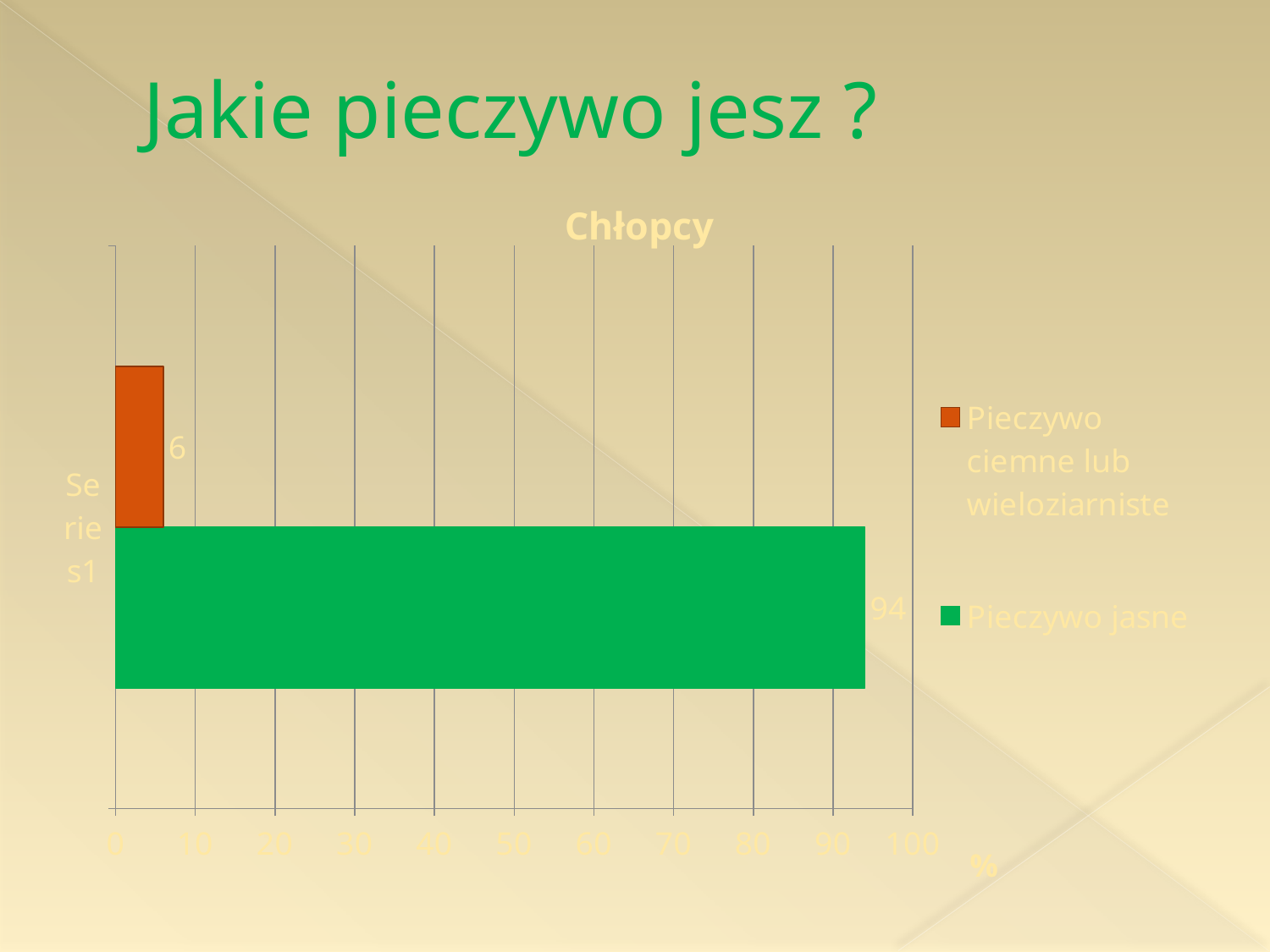
What is the title of the chart? Chłopcy What is the difference between the values for Pieczywo jasne and Pieczywo ciemne lub wieloziarniste? 88 What kind of chart is shown on the slide? Bar chart How many series does the legend list? 2 Is the value for Pieczywo ciemne lub wieloziarniste greater or less than 10? less Which series has the higher value, Pieczywo jasne or Pieczywo ciemne lub wieloziarniste? Pieczywo jasne Which series has the highest value? Pieczywo jasne What is the value for Pieczywo ciemne lub wieloziarniste? 6 Is the value for Pieczywo jasne greater or less than 90? greater What is the value for Pieczywo jasne? 94 What is the maximum value shown on the horizontal axis? 100 Which series has the lowest value? Pieczywo ciemne lub wieloziarniste